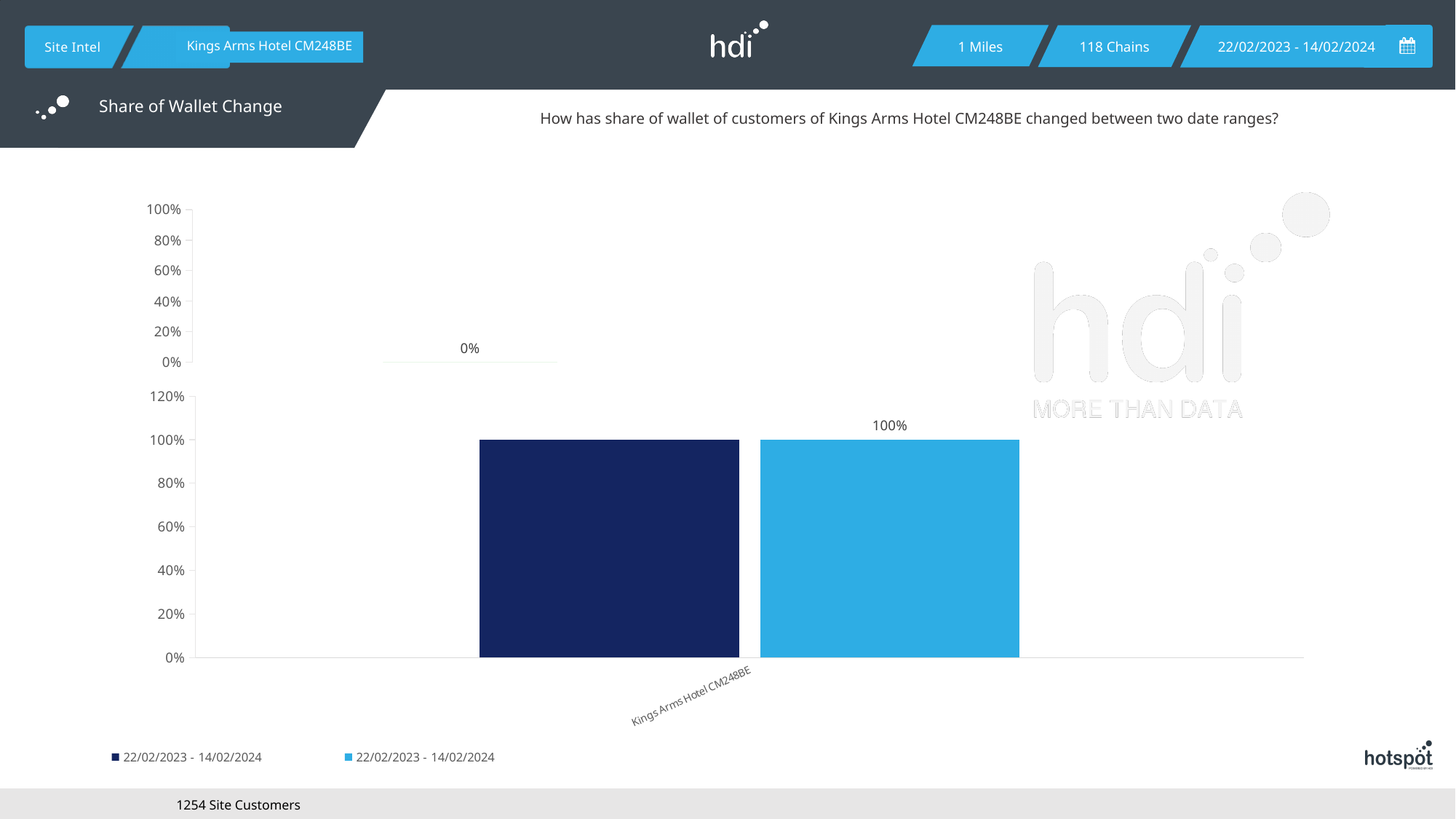
In the lower chart, how many categories are shown on the x axis? 1 In the lower chart, is the value of the dark navy bar greater or less than 80%? greater What text is shown for the first legend entry at the bottom of the slide? 22/02/2023 - 14/02/2024 What kind of chart is the lower chart on the slide? bar chart In the lower chart, do the dark navy bar and the light blue bar reach the same height? yes In the lower chart, what value is printed above the light blue bar? 100% What is the category label on the x axis of the lower chart? Kings Arms Hotel CM248BE How many series does the legend at the bottom of the slide list? 2 What is the highest tick shown on the y axis of the lower chart? 120% In the upper chart, what value is printed as the data label? 0% In the lower chart, what value does the dark navy bar reach on the y axis? 100%